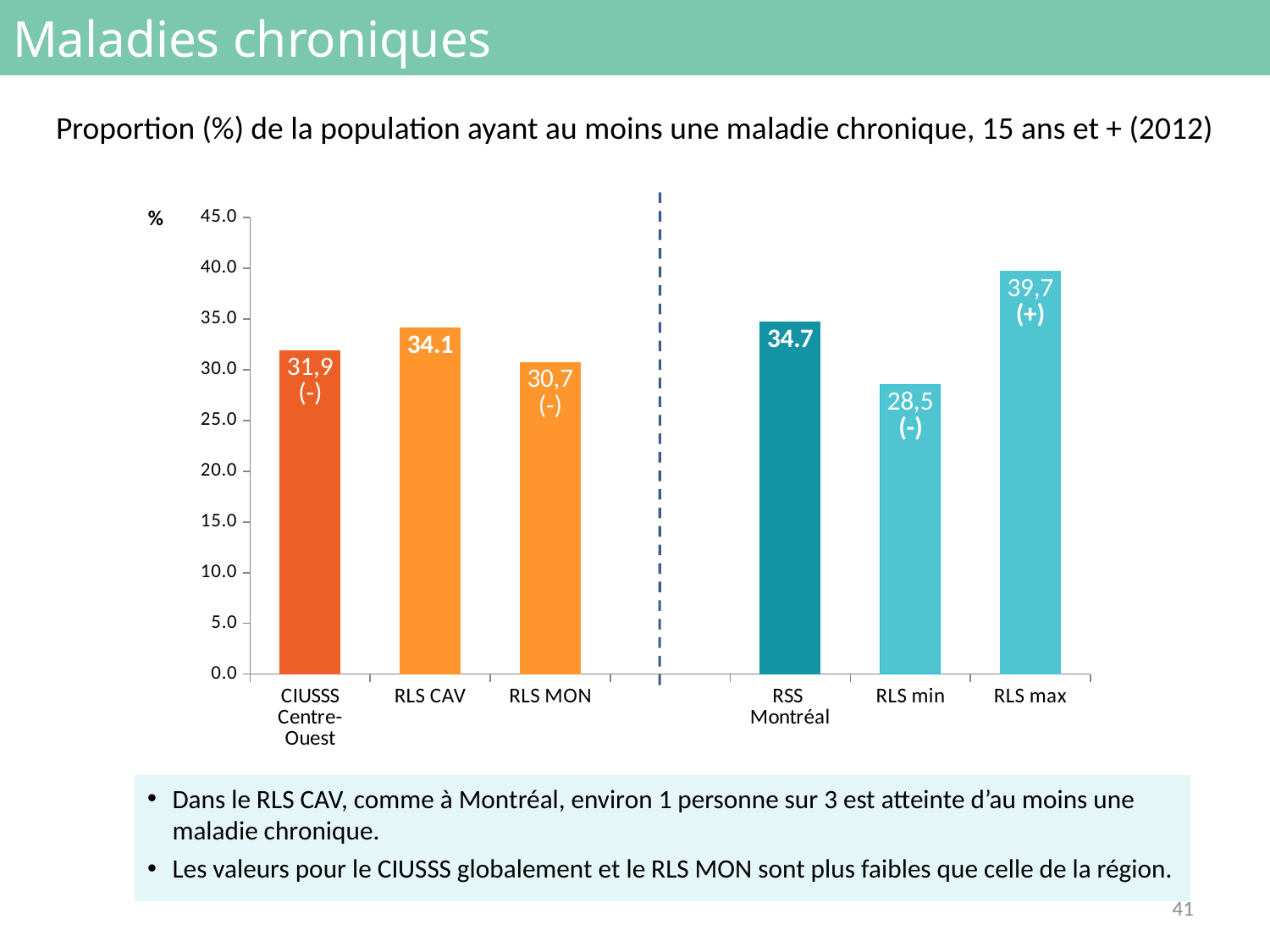
What is the difference between the values for CIUSSS Centre-Ouest and RLS MON? 1,2 What is the value for RLS min? 28,5 Which category has the lowest value? RLS min What is the value for CIUSSS Centre-Ouest? 31,9 Which is larger, the value for RLS MON or the value for RSS Montréal? RSS Montréal What is the value for RSS Montréal? 34.7 Which category has the highest value? RLS max What is the value for RLS CAV? 34.1 How many bars are shown in the chart? 6 Is the value for RLS max greater or less than 35.0? greater What kind of chart is shown on the slide? bar chart What is the difference between the values for RLS max and RLS min? 11,2